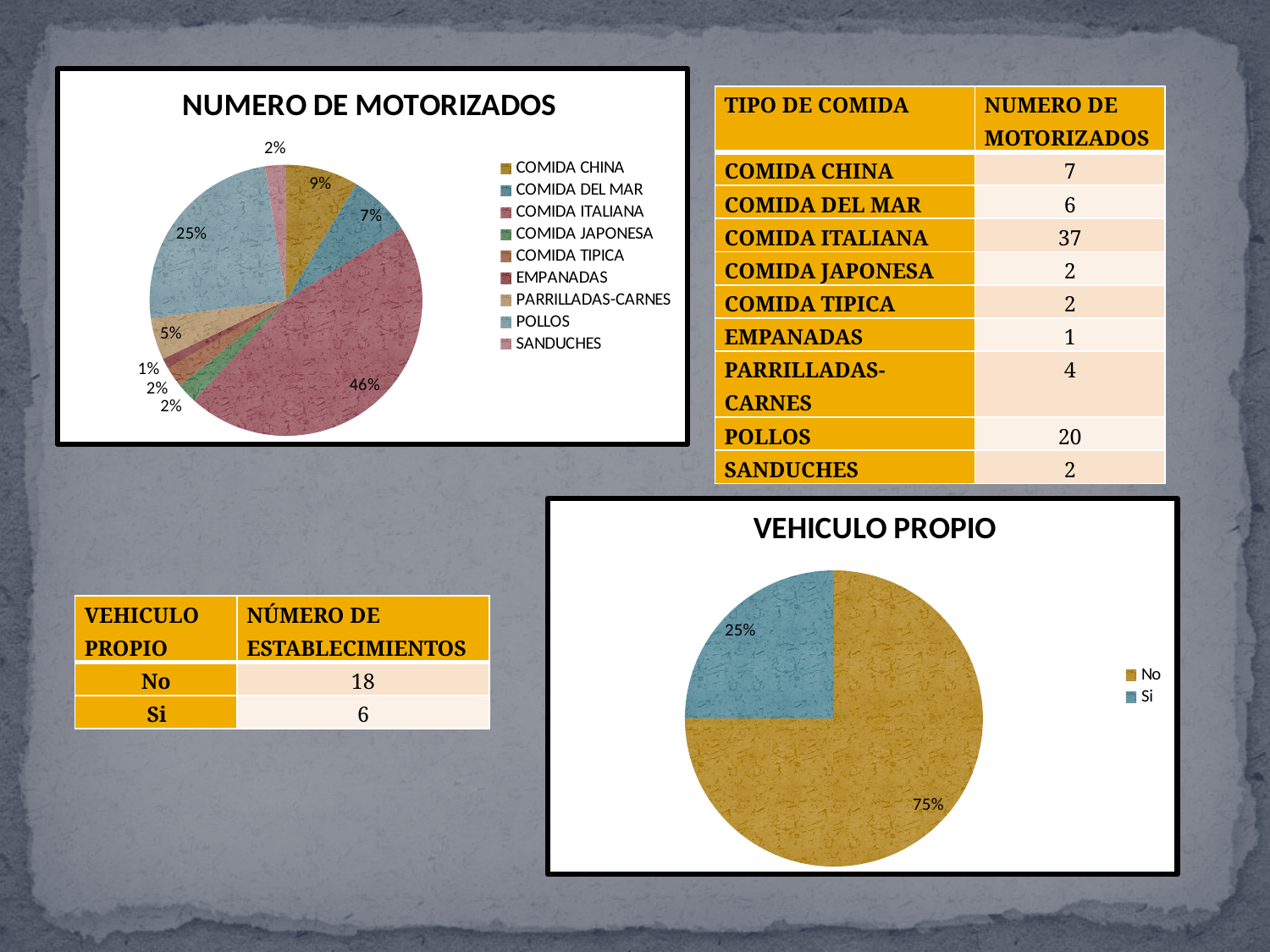
In the NUMERO DE MOTORIZADOS chart, which category has the largest slice? COMIDA ITALIANA In the NUMERO DE MOTORIZADOS chart, which is larger, COMIDA CHINA or COMIDA DEL MAR? COMIDA CHINA In the NUMERO DE MOTORIZADOS chart, what is the difference in percentage points between COMIDA ITALIANA and POLLOS? 21 In the VEHICULO PROPIO chart, how many series does the legend list? 2 In the NUMERO DE MOTORIZADOS chart, what percentage is shown for COMIDA CHINA? 9% In the NUMERO DE MOTORIZADOS chart, how many categories does the legend list? 9 In the VEHICULO PROPIO chart, what share of the pie is No? 75% In the NUMERO DE MOTORIZADOS chart, which category has the smallest slice? EMPANADAS What kind of chart is the VEHICULO PROPIO chart? Pie chart In the NUMERO DE MOTORIZADOS chart, what share of the pie is COMIDA ITALIANA? 46% In the NUMERO DE MOTORIZADOS chart, what percentage is shown for COMIDA DEL MAR? 7% In the NUMERO DE MOTORIZADOS chart, what share of the pie is POLLOS? 25%